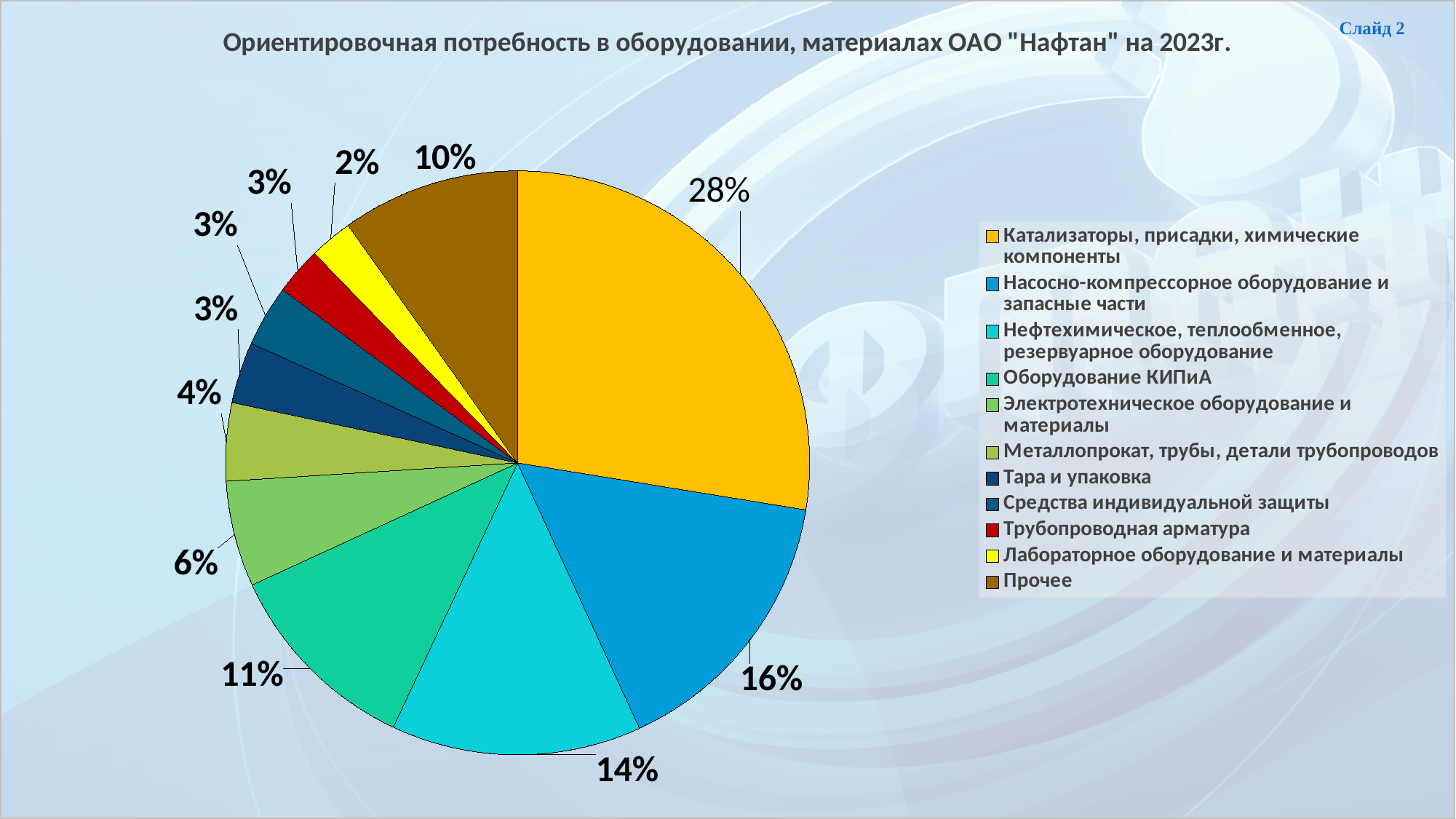
What is the difference in percentage points between "Катализаторы, присадки, химические компоненты" and "Насосно-компрессорное оборудование и запасные части"? 12 Which category has the smallest share of the pie? Лабораторное оборудование и материалы How many categories does the legend list? 11 Which category has the largest share of the pie? Катализаторы, присадки, химические компоненты What percentage is shown for "Оборудование КИПиА"? 11% What percentage is shown for "Насосно-компрессорное оборудование и запасные части"? 16% What percentage is shown for "Нефтехимическое, теплообменное, резервуарное оборудование"? 14% Which is larger: the share for "Электротехническое оборудование и материалы" or for "Металлопрокат, трубы, детали трубопроводов"? Электротехническое оборудование и материалы What percentage is shown for "Прочее"? 10% What percentage is shown for "Лабораторное оборудование и материалы"? 2% What share of the pie does "Катализаторы, присадки, химические компоненты" have? 28% What type of chart is shown on the slide? Pie chart